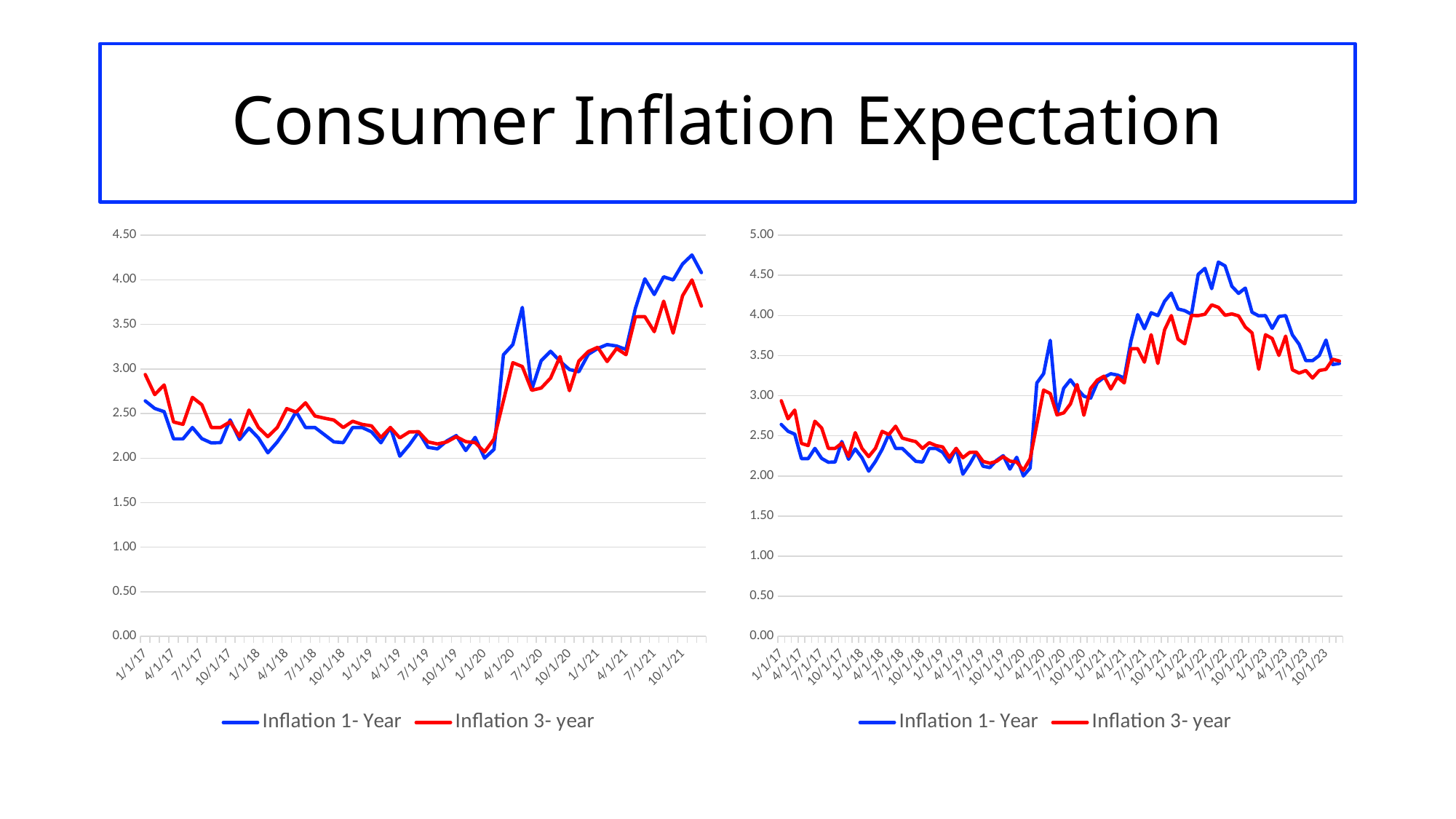
In the right chart, is the value for Inflation 3- year at 10/1/23 greater or less than 4.00? less In the right chart, is the value for Inflation 1- Year at 4/1/22 greater or less than 4.00? greater What kind of chart is the chart on the left of the slide? Line chart In the right chart, which series is higher at 4/1/22, Inflation 1- Year or Inflation 3- year? Inflation 1- Year In the left chart, is the value for Inflation 1- Year at 1/1/20 greater or less than 2.50? less In the right chart, does the Inflation 1- Year series generally rise or fall between 7/1/22 and 10/1/23? Fall In the left chart, which colour is used for the Inflation 3- year series? Red How many series does the legend of the right chart list? 2 In the left chart, does the Inflation 1- Year series generally rise or fall between 1/1/20 and 10/1/21? Rise In the left chart, which series is higher at 1/1/17, Inflation 1- Year or Inflation 3- year? Inflation 3- year What is the title of the slide containing the two charts? Consumer Inflation Expectation